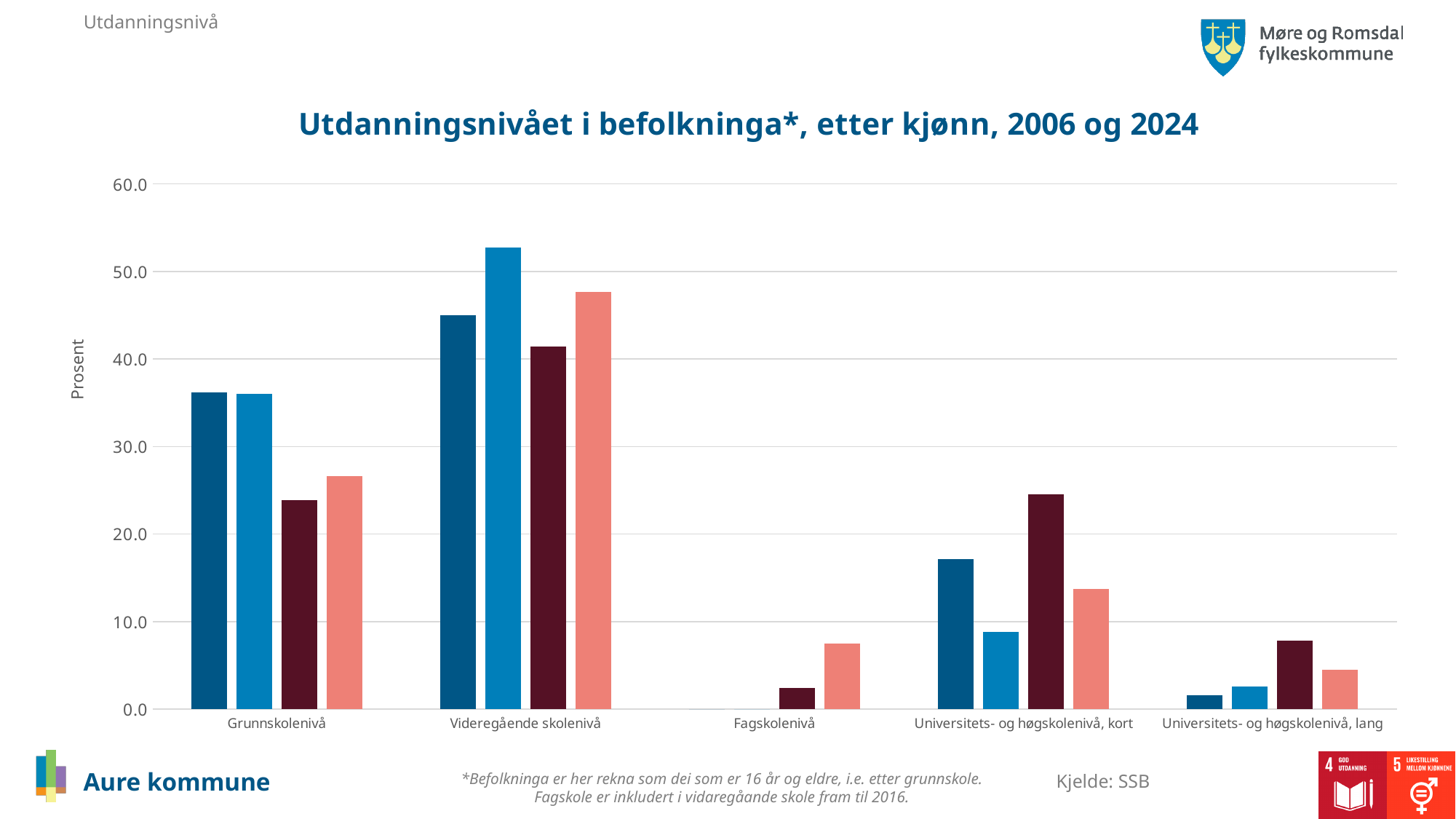
Is the value of the salmon-coloured bar for Fagskolenivå greater or less than 10? less What is the label of the y axis? Prosent Is the value of the dark blue bar for Grunnskolenivå greater or less than 30? greater What is the title of the chart? Utdanningsnivået i befolkninga*, etter kjønn, 2006 og 2024 Is the value of the light blue bar for Videregående skolenivå greater or less than 50? greater How many bars are plotted for each category? 4 What kind of chart is shown on the slide? bar chart For Grunnskolenivå, which is larger: the dark blue bar or the salmon-coloured bar? the dark blue bar For Universitets- og høgskolenivå, kort, which is larger: the light blue bar or the dark maroon bar? the dark maroon bar How many education-level categories are shown on the x axis? 5 Which category contains the tallest bar in the chart? Videregående skolenivå